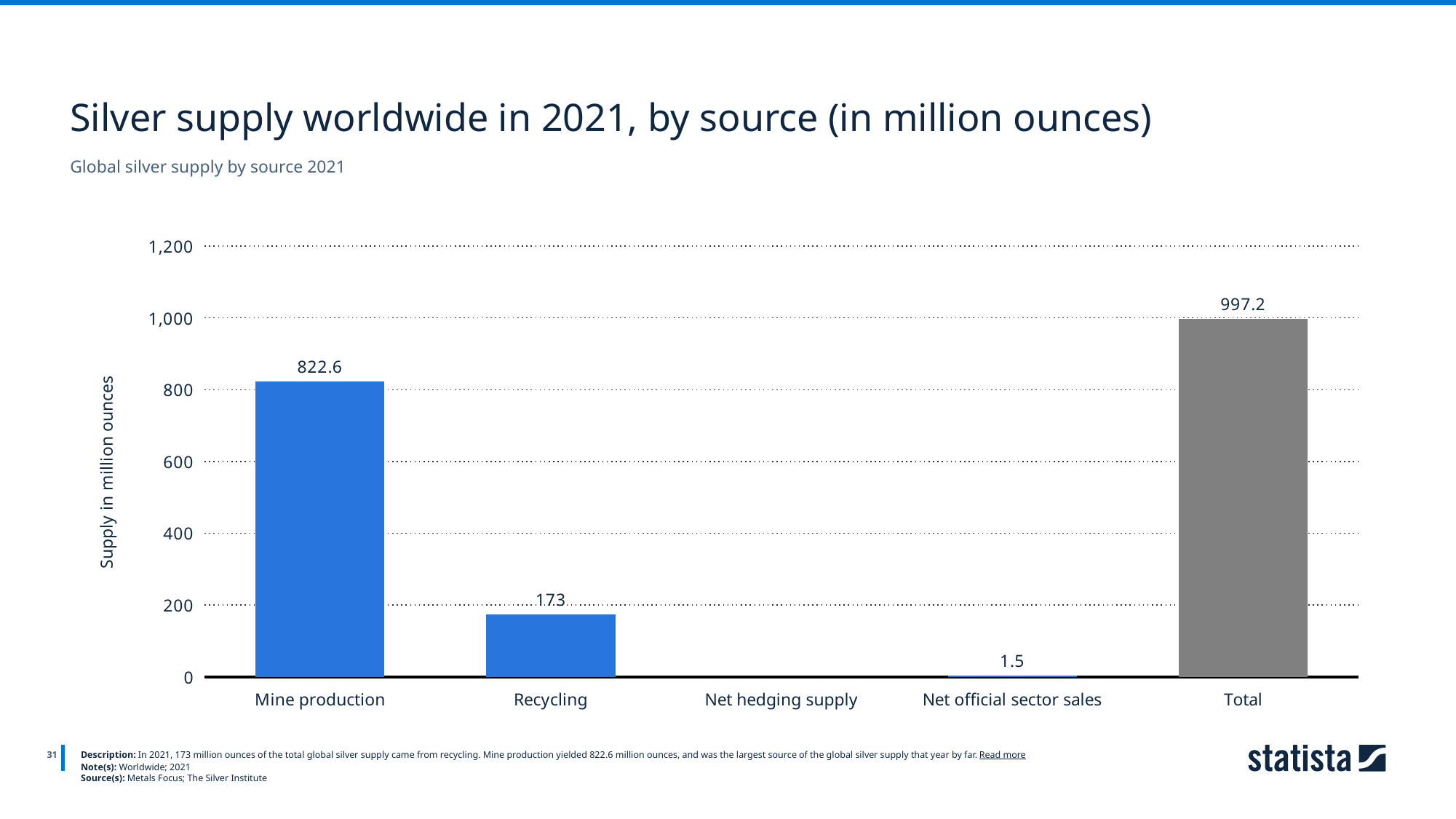
What is the difference between Total and Mine production? 174.6 How many categories are shown on the x axis? 5 Which category has the highest value? Total What is the label of the y axis? Supply in million ounces What kind of chart is shown on the slide? bar chart What is the value for Mine production? 822.6 What is the value for Net official sector sales? 1.5 What is the value for Total? 997.2 What is the difference between Mine production and Recycling? 649.6 Which is larger, Mine production or Recycling? Mine production What is the value for Recycling? 173 Is the value for Recycling greater or less than 200? less